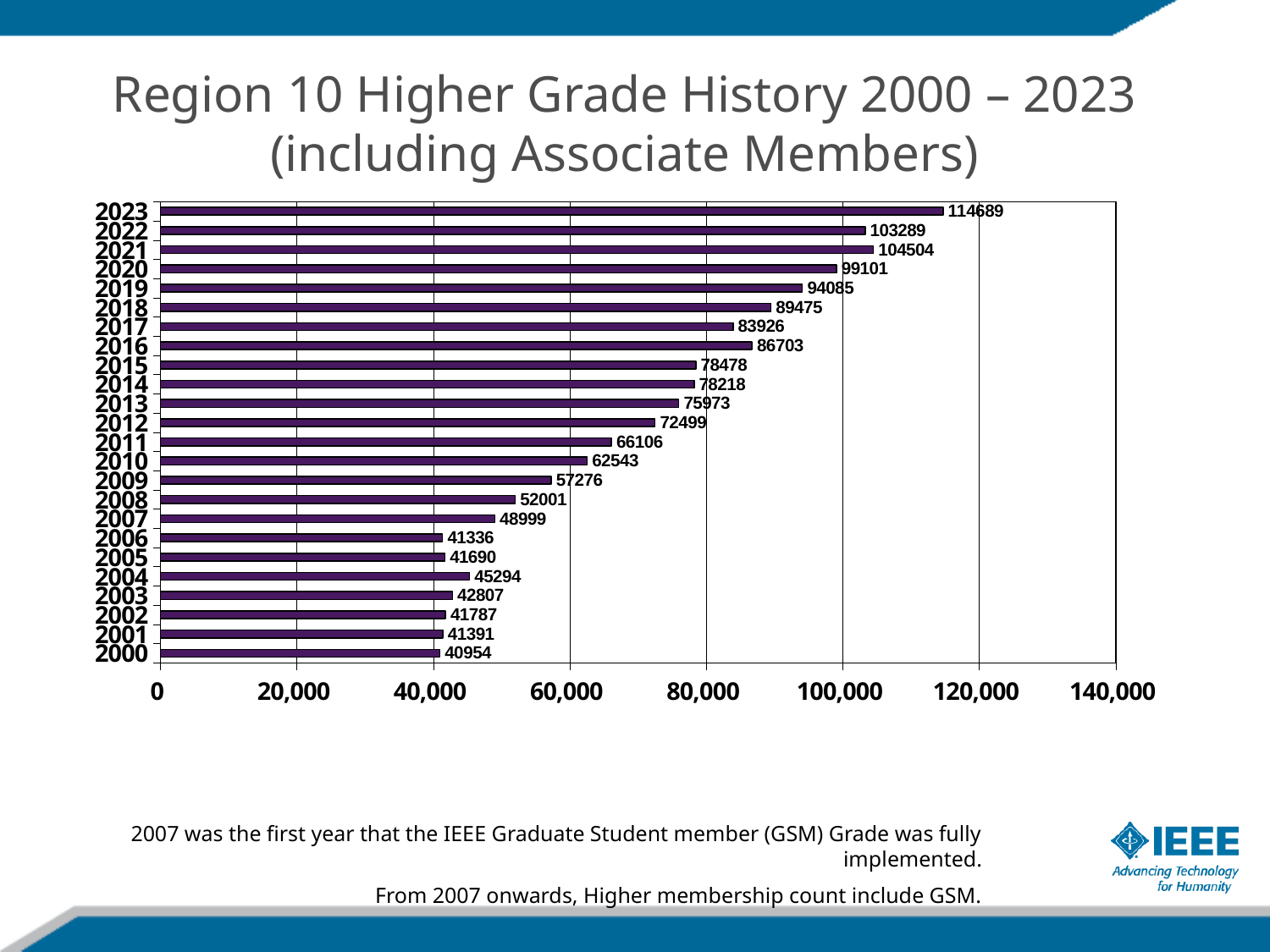
Which year has the lowest value? 2000 What type of chart is shown on the slide? Bar chart Which is larger, the value for 2016 or the value for 2017? 2016 How many years are shown in the chart? 24 Do the values generally rise or fall from 2000 to 2023? Rise What is the value for 2012? 72499 What is the value for 2007? 48999 What is the difference between the values for 2023 and 2000? 73735 Which year has the highest value? 2023 What is the difference between the values for 2021 and 2022? 1215 Is the value for 2020 greater or less than 80,000? greater What is the value for 2023? 114689